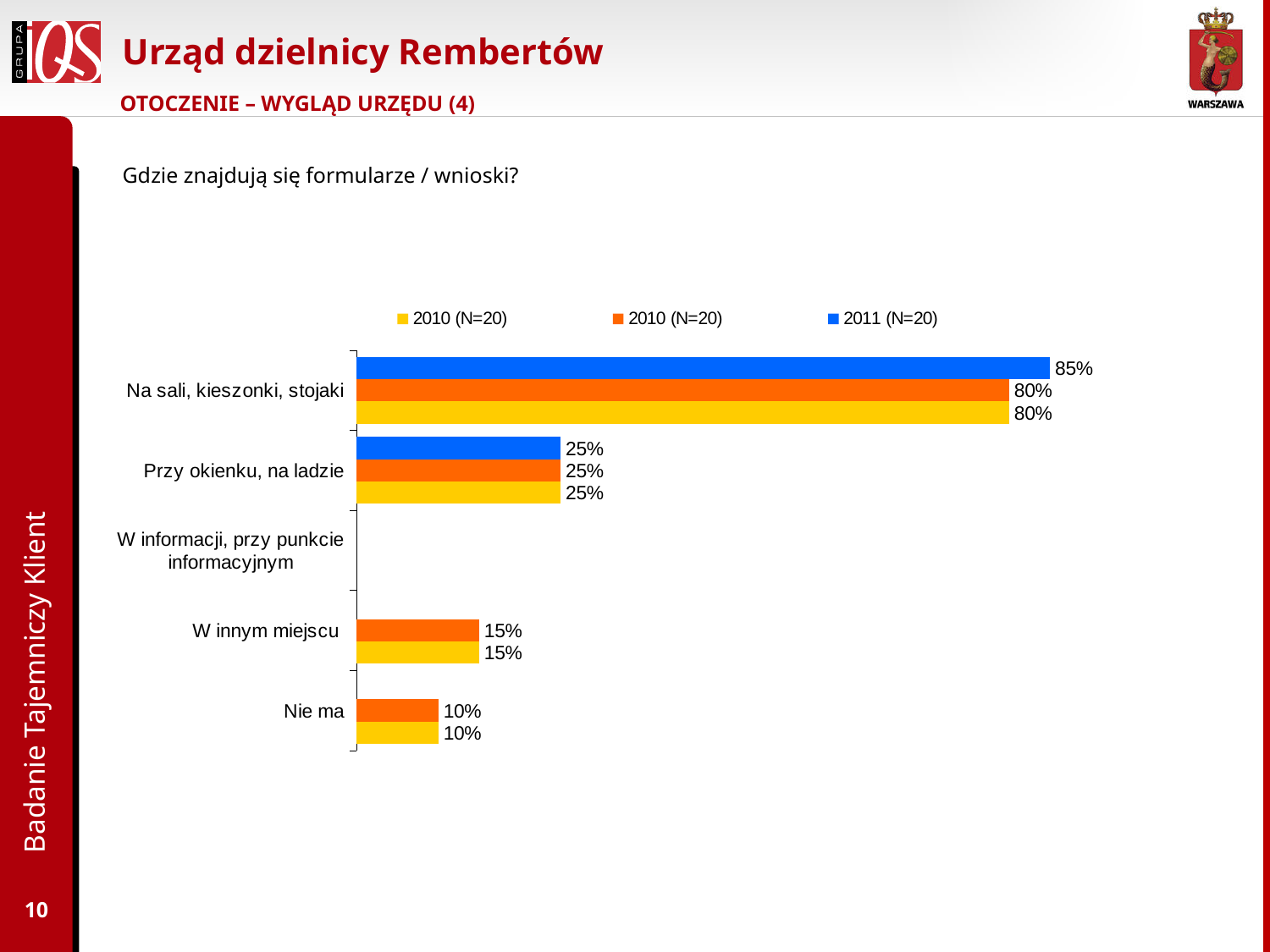
What is the value for "Nie ma" in the orange 2010 (N=20) series? 10% Which category has the lowest non-zero value in the orange 2010 (N=20) series? Nie ma What question does the chart on the slide answer? Gdzie znajdują się formularze / wnioski? Which category has the highest value in the 2011 (N=20) series? Na sali, kieszonki, stojaki What is the value for "Na sali, kieszonki, stojaki" in the 2011 (N=20) series? 85% What kind of chart is shown on the slide? Bar chart How many categories are shown on the chart? 5 For "Na sali, kieszonki, stojaki", which is larger: the 2011 (N=20) value or the yellow 2010 (N=20) value? 2011 (N=20) How many series does the legend list? 3 What is the value for "W innym miejscu" in the yellow 2010 (N=20) series? 15% What is the value for "Przy okienku, na ladzie" in the 2011 (N=20) series? 25% What is the difference between the 2011 (N=20) value and the orange 2010 (N=20) value for "Na sali, kieszonki, stojaki"? 5%